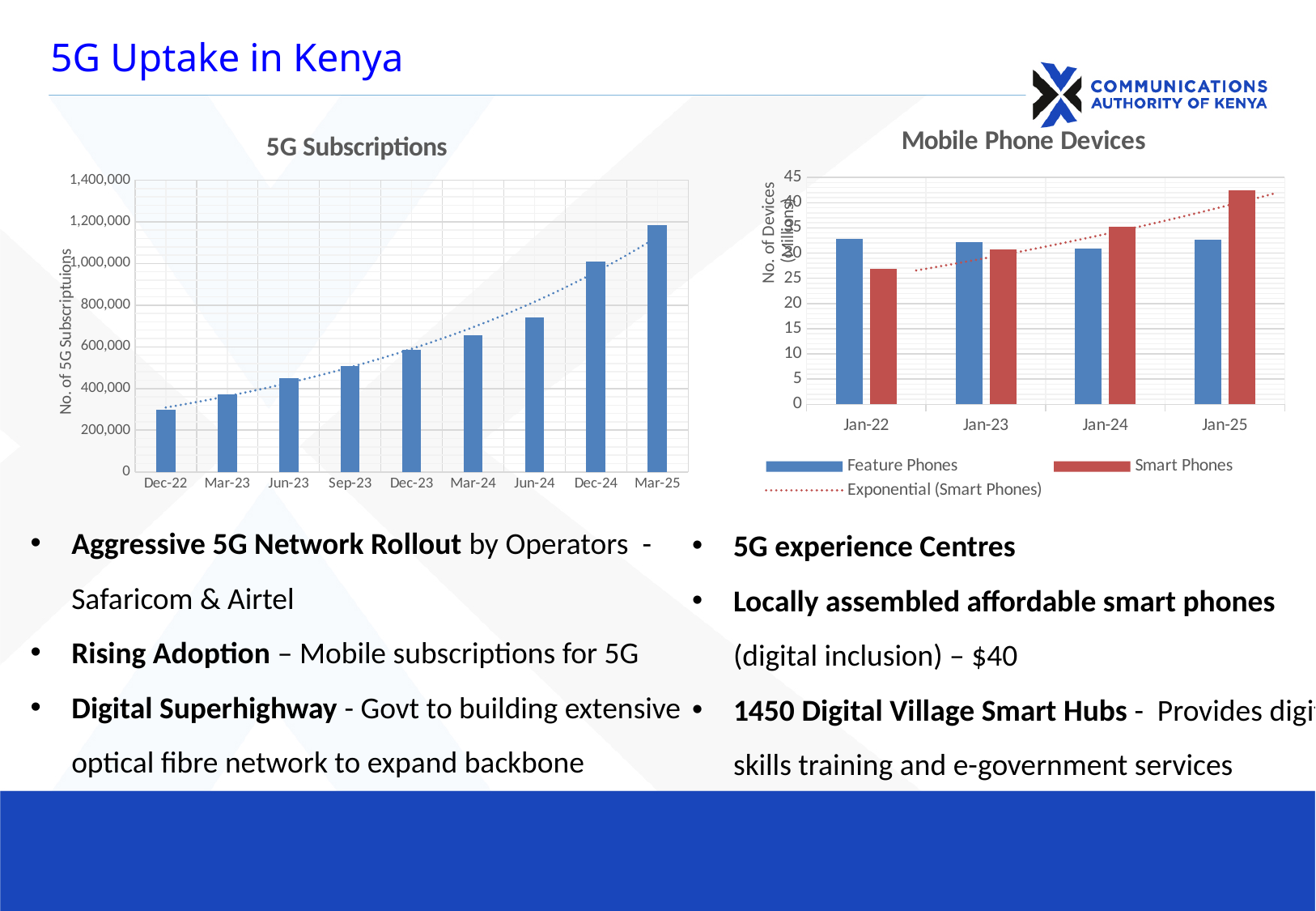
How many periods are shown on the x axis of the 5G Subscriptions chart? 9 In the Mobile Phone Devices chart, which is larger at Jan-22: Feature Phones or Smart Phones? Feature Phones In the Mobile Phone Devices chart, which is larger at Jan-25: Feature Phones or Smart Phones? Smart Phones In the Mobile Phone Devices chart, which year has the highest Smart Phones value? Jan-25 In the Mobile Phone Devices chart, is the Smart Phones value for Jan-22 greater or less than 30? less In the 5G Subscriptions chart, which period has the lowest number of subscriptions? Dec-22 What kind of chart is the 5G Subscriptions chart? bar chart In the 5G Subscriptions chart, is the value for Jun-24 greater or less than 800,000? less In the Mobile Phone Devices chart, how many entries does the legend list? 3 In the 5G Subscriptions chart, is the value for Mar-25 greater or less than 1,000,000? greater In the 5G Subscriptions chart, which period has the highest number of subscriptions? Mar-25 In the 5G Subscriptions chart, do the values rise or fall from Dec-22 to Mar-25? rise